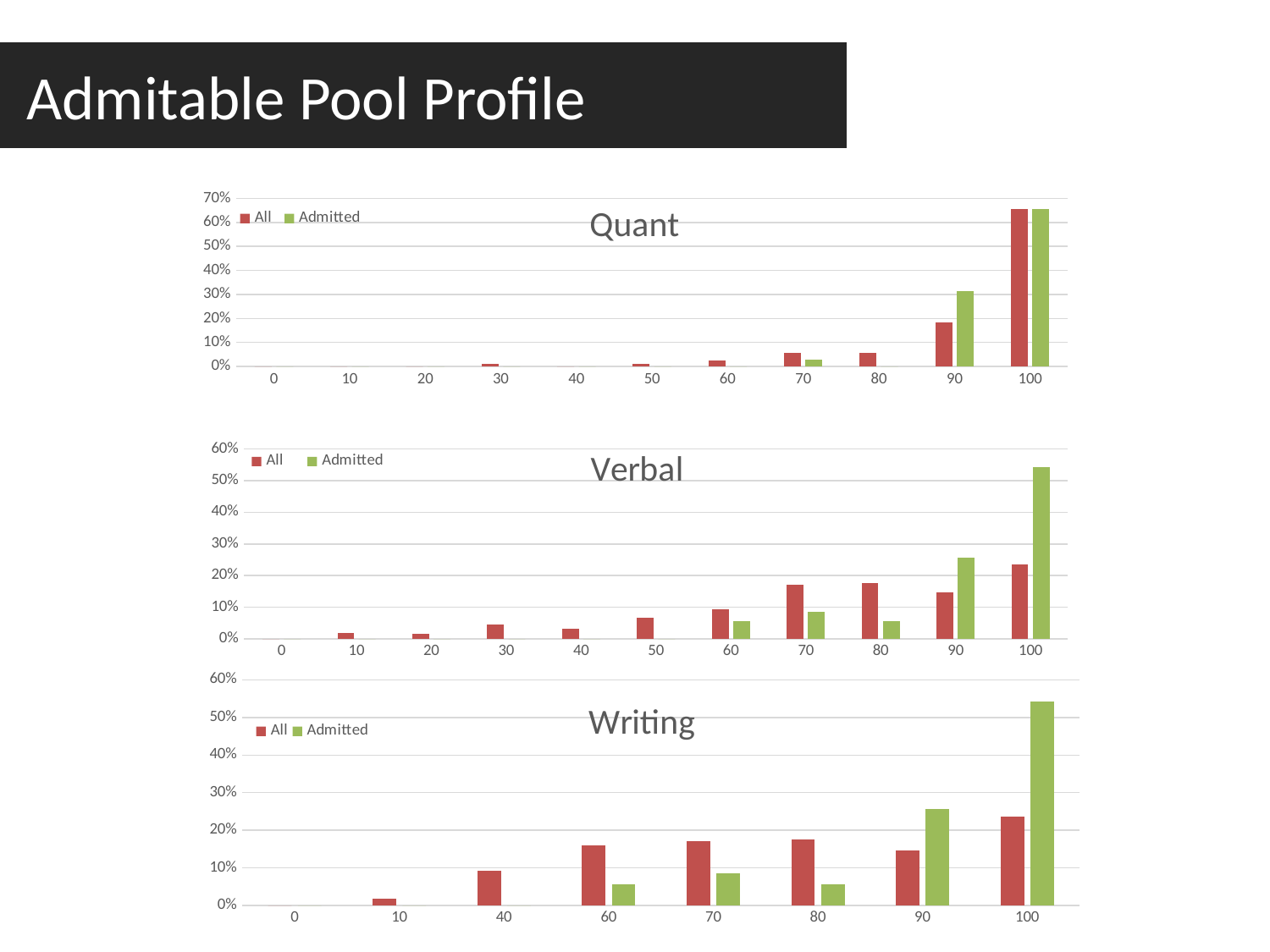
On the Quant chart, is the Admitted value at 90 greater or less than 20%? greater On the Quant chart, what kind of chart is shown? bar chart On the Writing chart, is the All value at 100 greater or less than 20%? greater What colour represents the Admitted series in the charts? green On the Quant chart, how many score categories are shown on the x axis? 11 On the Verbal chart, which is larger at 100, the All value or the Admitted value? Admitted On the Writing chart, how many score categories are shown on the x axis? 8 On the Quant chart, which score category has the highest All value? 100 On the Writing chart, which is larger at 90, the All value or the Admitted value? Admitted On the Verbal chart, is the Admitted value at 100 greater or less than 50%? greater On the Verbal chart, which score category has the highest Admitted value? 100 On the Quant chart, how many series does the legend list? 2